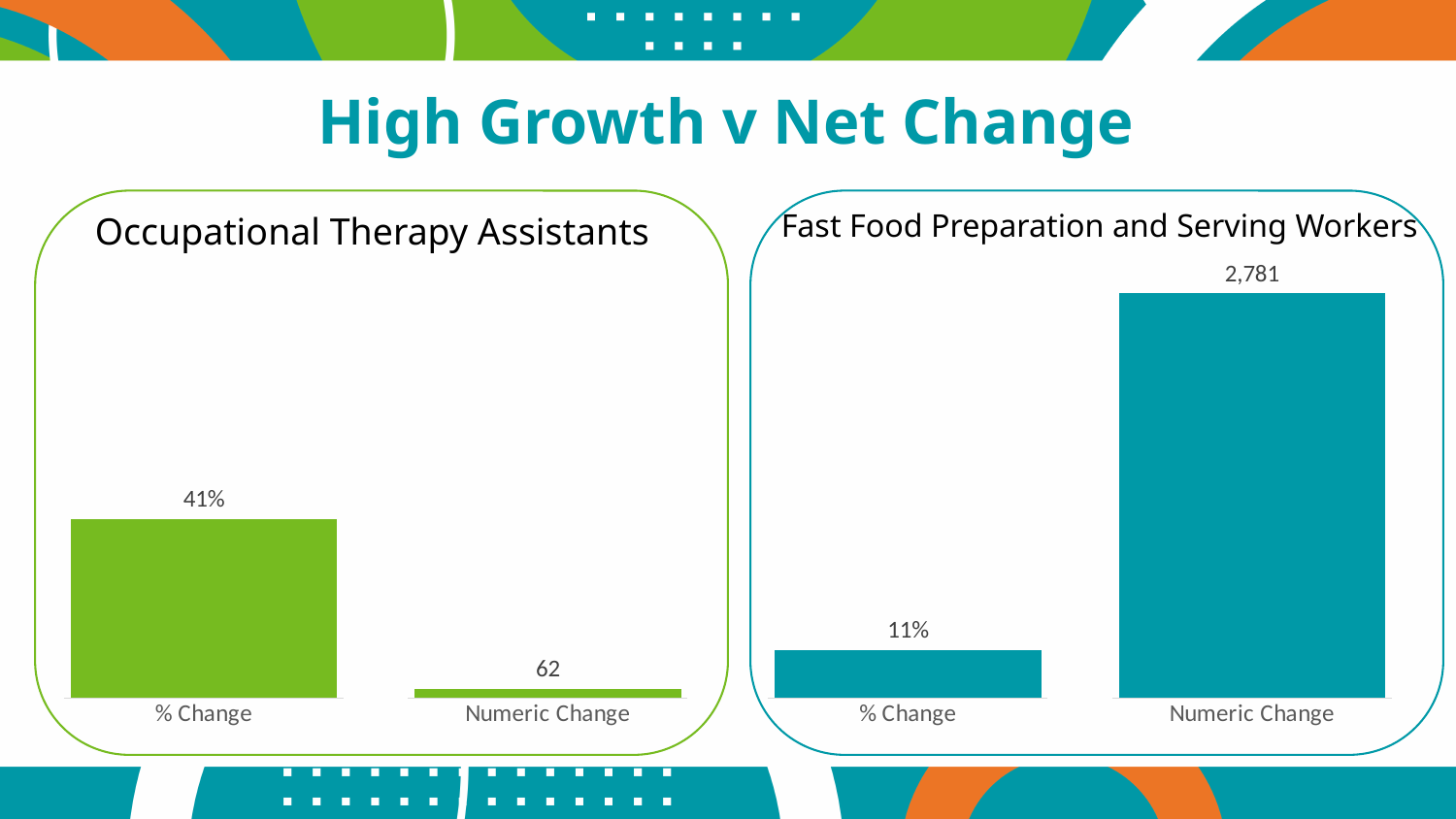
What is the title of the chart on the left side of the slide? Occupational Therapy Assistants Which occupation has the larger % Change, Occupational Therapy Assistants or Fast Food Preparation and Serving Workers? Occupational Therapy Assistants By how many percentage points does the % Change for Occupational Therapy Assistants exceed the % Change for Fast Food Preparation and Serving Workers? 30 In the Fast Food Preparation and Serving Workers chart, what is the value for Numeric Change? 2,781 What colour are the bars in the Fast Food Preparation and Serving Workers chart? Teal Which occupation has the larger Numeric Change, Occupational Therapy Assistants or Fast Food Preparation and Serving Workers? Fast Food Preparation and Serving Workers What is the difference between the Numeric Change for Fast Food Preparation and Serving Workers and the Numeric Change for Occupational Therapy Assistants? 2,719 In the Occupational Therapy Assistants chart, what is the value for % Change? 41% How many categories are shown in the Fast Food Preparation and Serving Workers chart? 2 In the Occupational Therapy Assistants chart, what is the value for Numeric Change? 62 What type of chart is the Occupational Therapy Assistants chart? Bar chart In the Fast Food Preparation and Serving Workers chart, what is the value for % Change? 11%